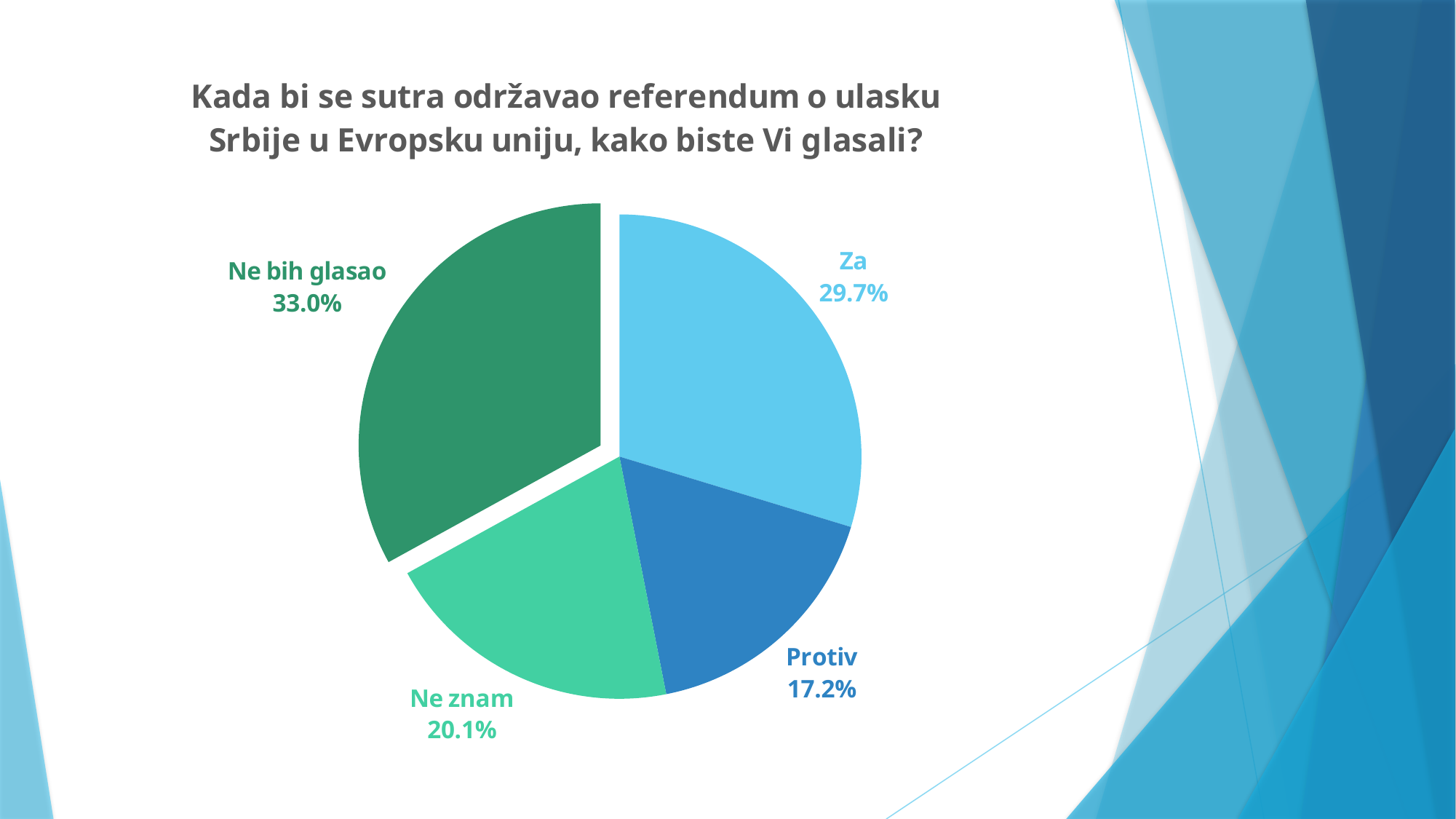
What is the difference in percentage points between "Ne bih glasao" and "Ne znam"? 12.9 Which response has the largest share of the pie? Ne bih glasao What percentage of respondents answered "Za"? 29.7% What is the title of the chart? Kada bi se sutra održavao referendum o ulasku Srbije u Evropsku uniju, kako biste Vi glasali? Which response has the smallest share of the pie? Protiv Which is larger, the share for "Ne znam" or the share for "Protiv"? Ne znam How many slices does the pie chart have? 4 What percentage of respondents answered "Protiv"? 17.2% What percentage of respondents answered "Ne bih glasao"? 33.0% What is the difference in percentage points between "Za" and "Protiv"? 12.5 What kind of chart is shown on the slide? pie chart What percentage of respondents answered "Ne znam"? 20.1%